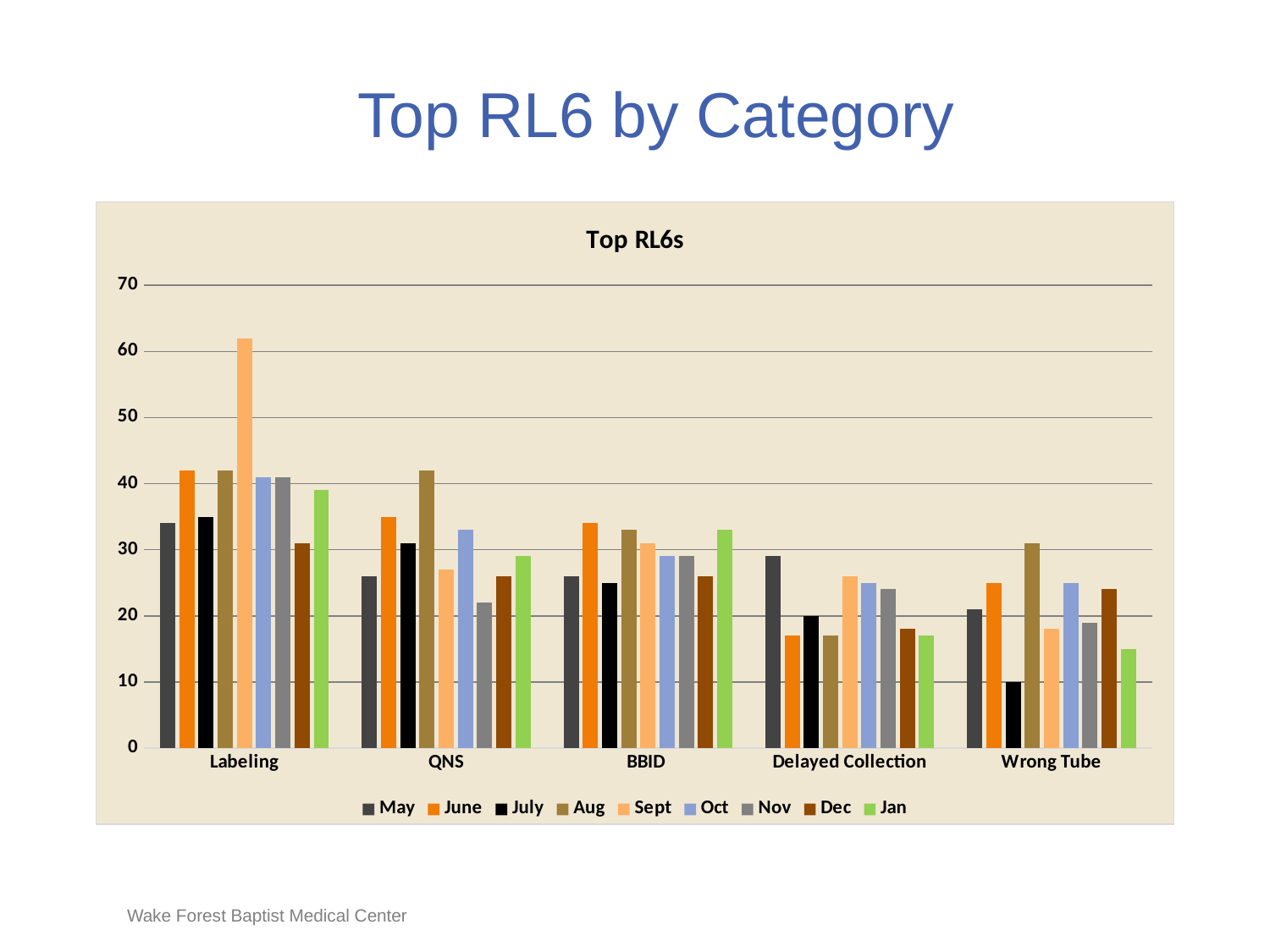
How many series does the legend list? 9 Which month has the highest value for Delayed Collection? May Which month has the lowest value for Wrong Tube? July Is the value for Jan in the BBID category greater or less than 30? greater Which is larger: the Sept value for Labeling or the Sept value for QNS? Labeling Which month has the highest value for Labeling? Sept Is the value for July in the Wrong Tube category greater or less than 20? less Which is larger: the Aug value for Wrong Tube or the June value for Wrong Tube? Aug Is the value for Sept in the Labeling category greater or less than 50? greater What is the title of the chart? Top RL6s How many categories are shown on the x axis of the chart? 5 What kind of chart is shown on the slide? bar chart